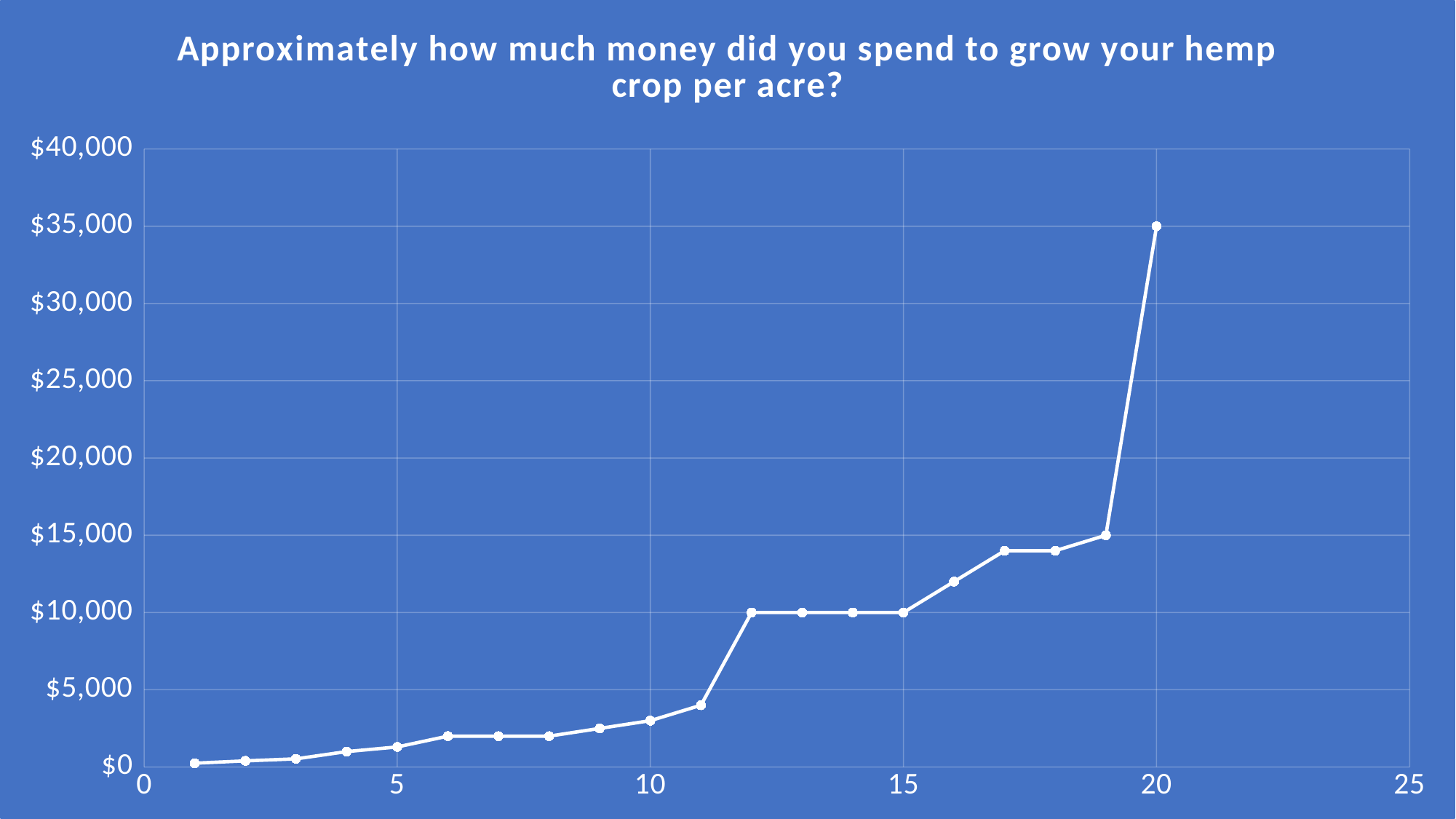
What is the title of the chart? Approximately how much money did you spend to grow your hemp crop per acre? Is the value at x = 11 greater or less than $5,000? less Which has the larger value, the point at x = 19 or the point at x = 20? x = 20 What kind of chart is shown on the slide? line chart What is the value of the point at x = 12? $10,000 What is the value of the point at x = 20? $35,000 Do the values generally rise or fall as x increases? rise What is the difference between the value at x = 20 and the value at x = 19? $20,000 How many data points are plotted on the chart? 20 Is the value at x = 16 greater or less than $10,000? greater At which x value does the chart reach its highest value? 20 What is the value of the point at x = 19? $15,000